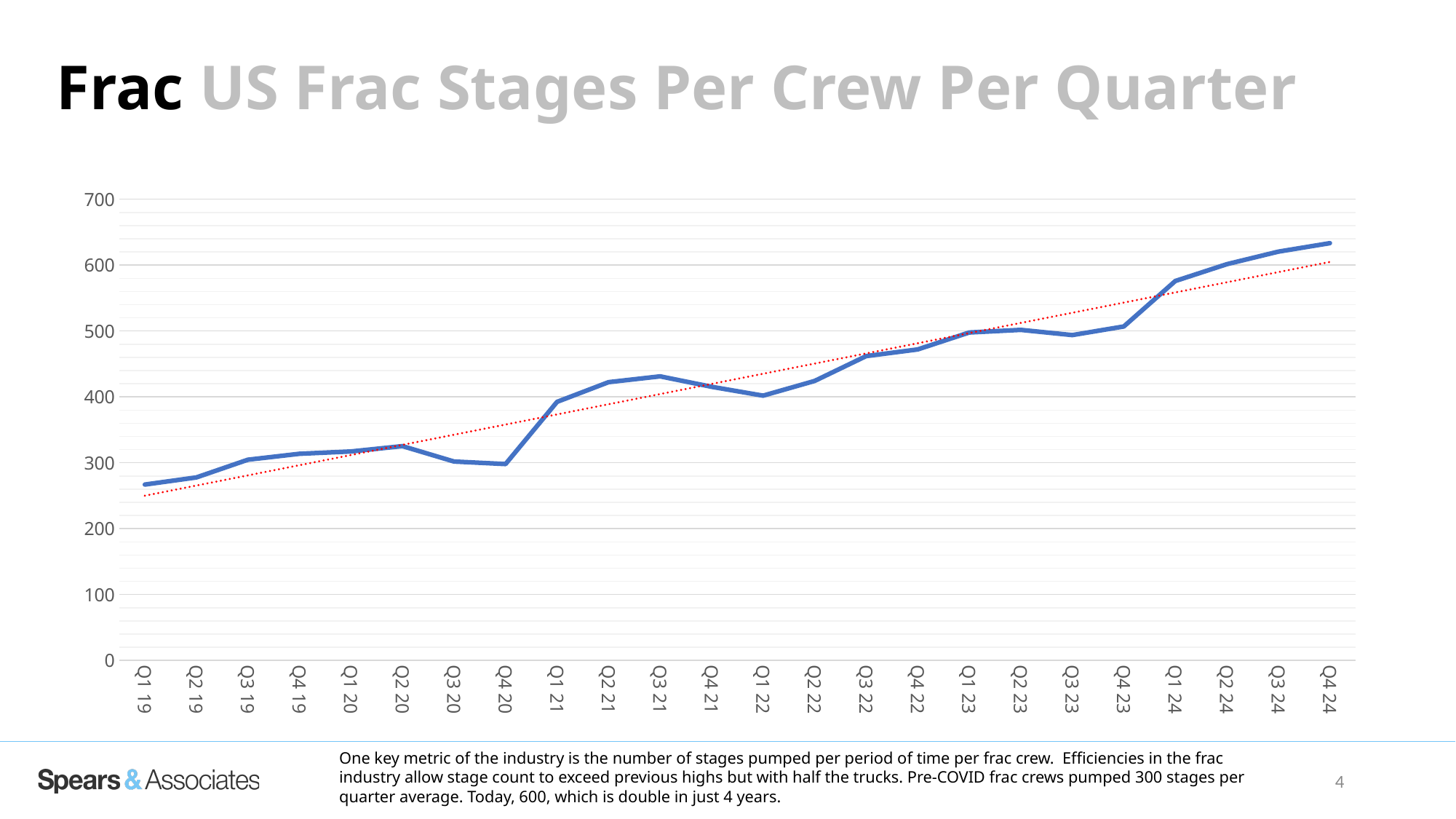
What is the title of the chart? US Frac Stages Per Crew Per Quarter Do the values generally rise or fall from Q1 19 to Q4 24? rise Which quarter has the highest value? Q4 24 Which is larger, the value for Q1 24 or the value for Q4 23? Q1 24 Is the value for Q4 24 greater or less than 600? greater Is the value for Q1 19 greater or less than 300? less What kind of chart is shown on the slide? line chart How many quarters are plotted along the x axis? 24 Is the value for Q1 24 greater or less than 600? less Which is larger, the value for Q3 21 or the value for Q1 22? Q3 21